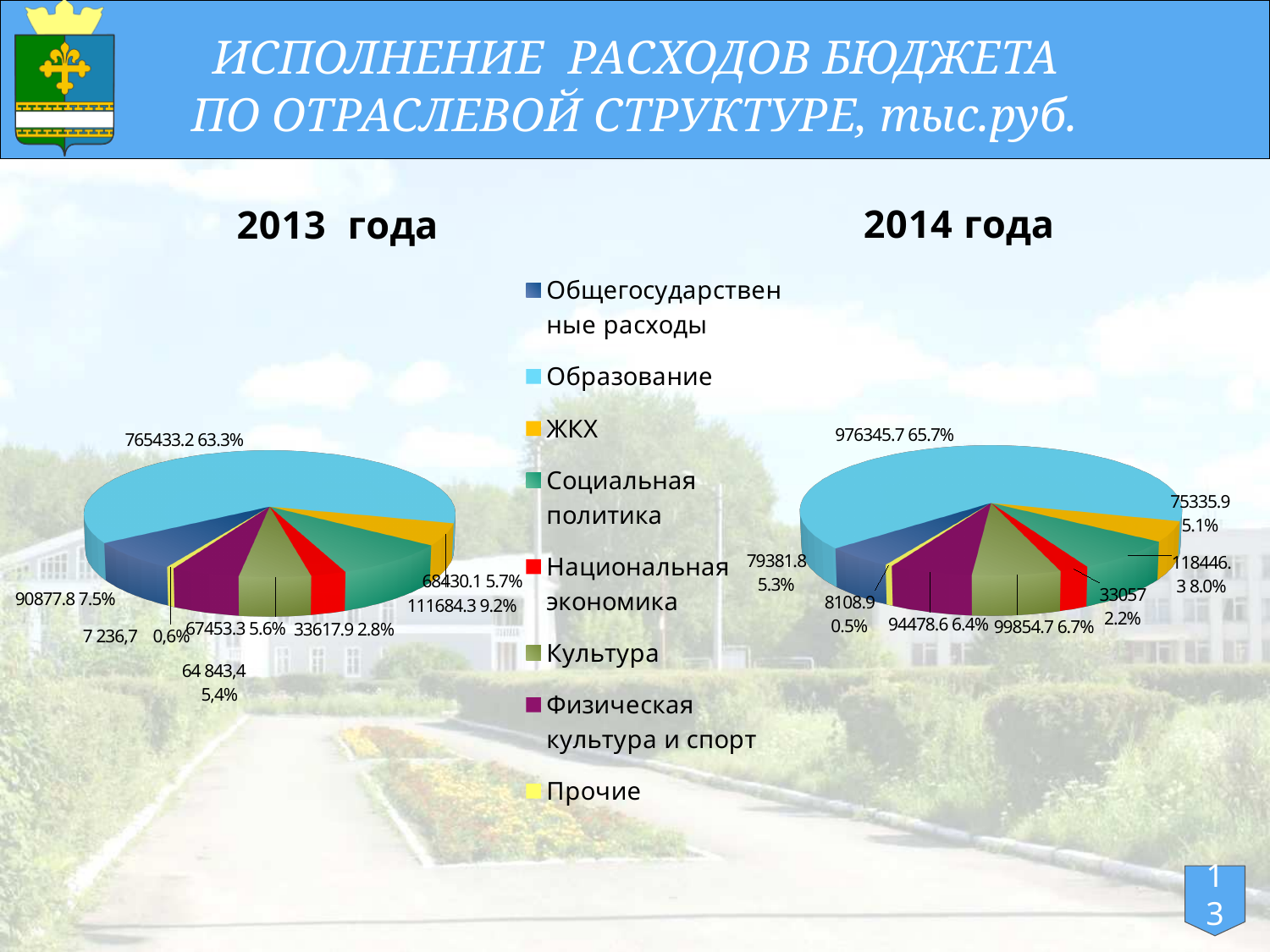
In the 2014 года chart, what share of the pie does Образование take? 65.7% In the 2014 года chart, what share of the pie does Национальная экономика take? 2.2% In the 2013 года chart, which category has the largest slice? Образование In the 2014 года chart, what is the value for Образование? 976345.7 In the 2013 года chart, what share of the pie does Образование take? 63.3% In the 2014 года chart, which category has the smallest slice? Прочие In the 2014 года chart, what is the value for Социальная политика? 118446.3 Which chart shows a larger share for Образование, 2013 года or 2014 года? 2014 года In the 2013 года chart, what is the value for Социальная политика? 111684.3 What kind of charts are shown on the slide? Pie charts How many categories does the legend list? 8 In the 2013 года chart, what is the value for Образование? 765433.2